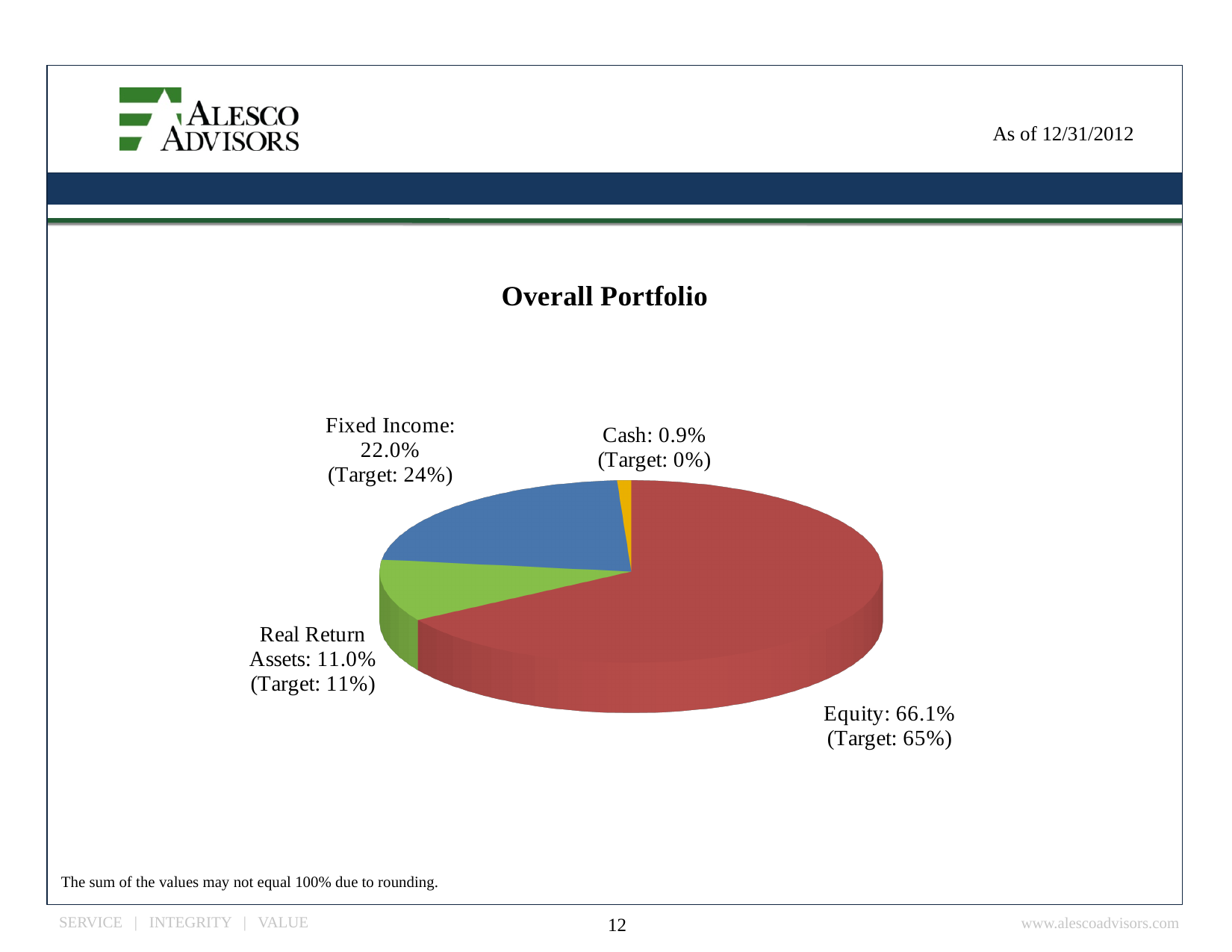
What is the difference between the Fixed Income share and the Real Return Assets share? 11.0% What share of the portfolio is Fixed Income? 22.0% Which category has the smallest slice of the pie? Cash How many categories are shown in the pie chart? 4 What share of the portfolio is Real Return Assets? 11.0% What is the title of the chart? Overall Portfolio What share of the portfolio is Cash? 0.9% What is the target allocation for Fixed Income? 24% What share of the portfolio is Equity? 66.1% What kind of chart is shown on the slide? Pie chart Which category has the largest slice of the pie? Equity Which is larger, the Fixed Income share or the Real Return Assets share? Fixed Income